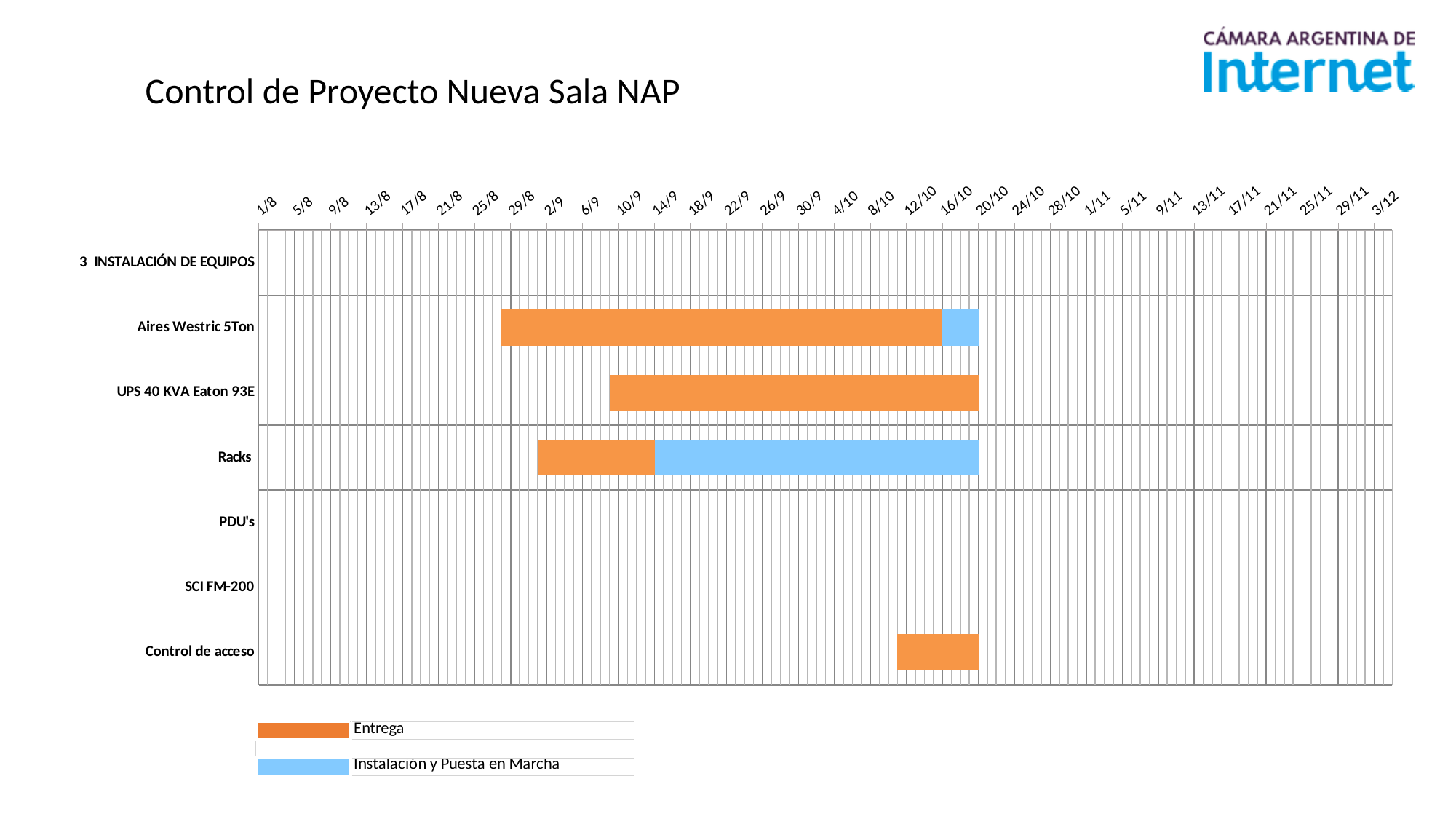
Which task has a longer 'Entrega' (orange) segment, Racks or UPS 40 KVA Eaton 93E? UPS 40 KVA Eaton 93E Does the bar for Control de acceso start before or after 8/10? after Does the bar for Aires Westric 5Ton start before or after 1/9? before How many series does the legend list? 2 Which task has the shortest bar among the tasks that have a bar? Control de acceso What does the light blue colour represent according to the legend? Instalación y Puesta en Marcha Which colour represents 'Entrega' in the legend? Orange What kind of chart is shown on the slide? Gantt chart (horizontal bar chart) Which task has the longest 'Instalación y Puesta en Marcha' (blue) segment? Racks Which task has the longest overall bar in the chart? Aires Westric 5Ton Which task's bar starts earliest on the timeline? Aires Westric 5Ton How many task rows are listed on the vertical axis of the chart? 7